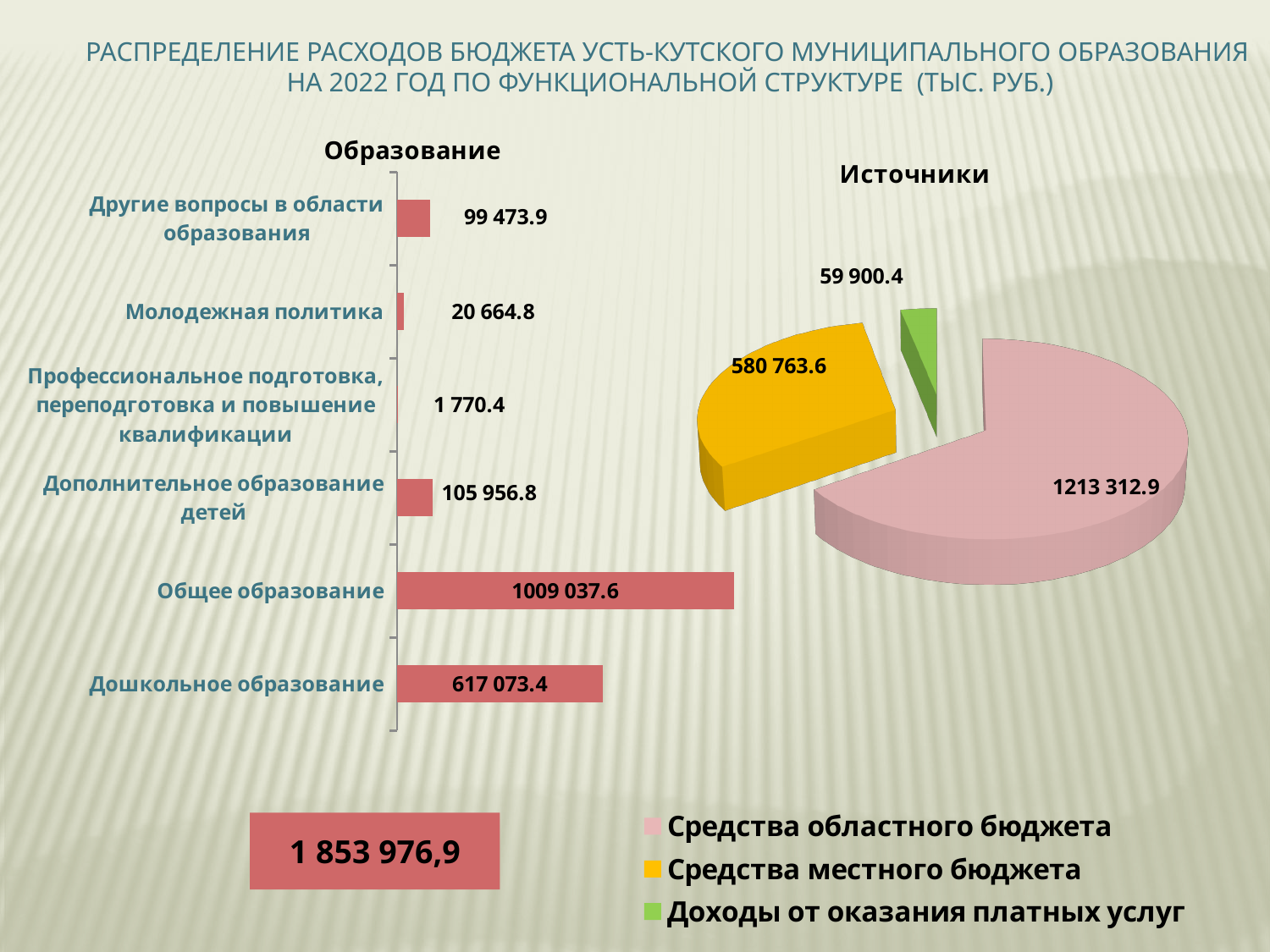
In the bar chart "Образование", which category has the highest value? Общее образование In the bar chart "Образование", what is the value for Дошкольное образование? 617 073.4 In the bar chart "Образование", what is the difference between Общее образование and Дошкольное образование? 391 964.2 In the bar chart "Образование", which category has the lowest value? Профессиональное подготовка, переподготовка и повышение квалификации How many entries does the legend of the pie chart "Источники" list? 3 In the pie chart "Источники", which source has the largest slice? Средства областного бюджета In the bar chart "Образование", what is the value for Молодежная политика? 20 664.8 In the pie chart "Источники", what is the difference between Средства областного бюджета and Средства местного бюджета? 632 549.3 In the bar chart "Образование", what is the value for Общее образование? 1009 037.6 How many categories does the bar chart "Образование" show? 6 In the bar chart "Образование", which is larger: Дополнительное образование детей or Другие вопросы в области образования? Дополнительное образование детей In the pie chart "Источники", what is the value for Средства местного бюджета? 580 763.6